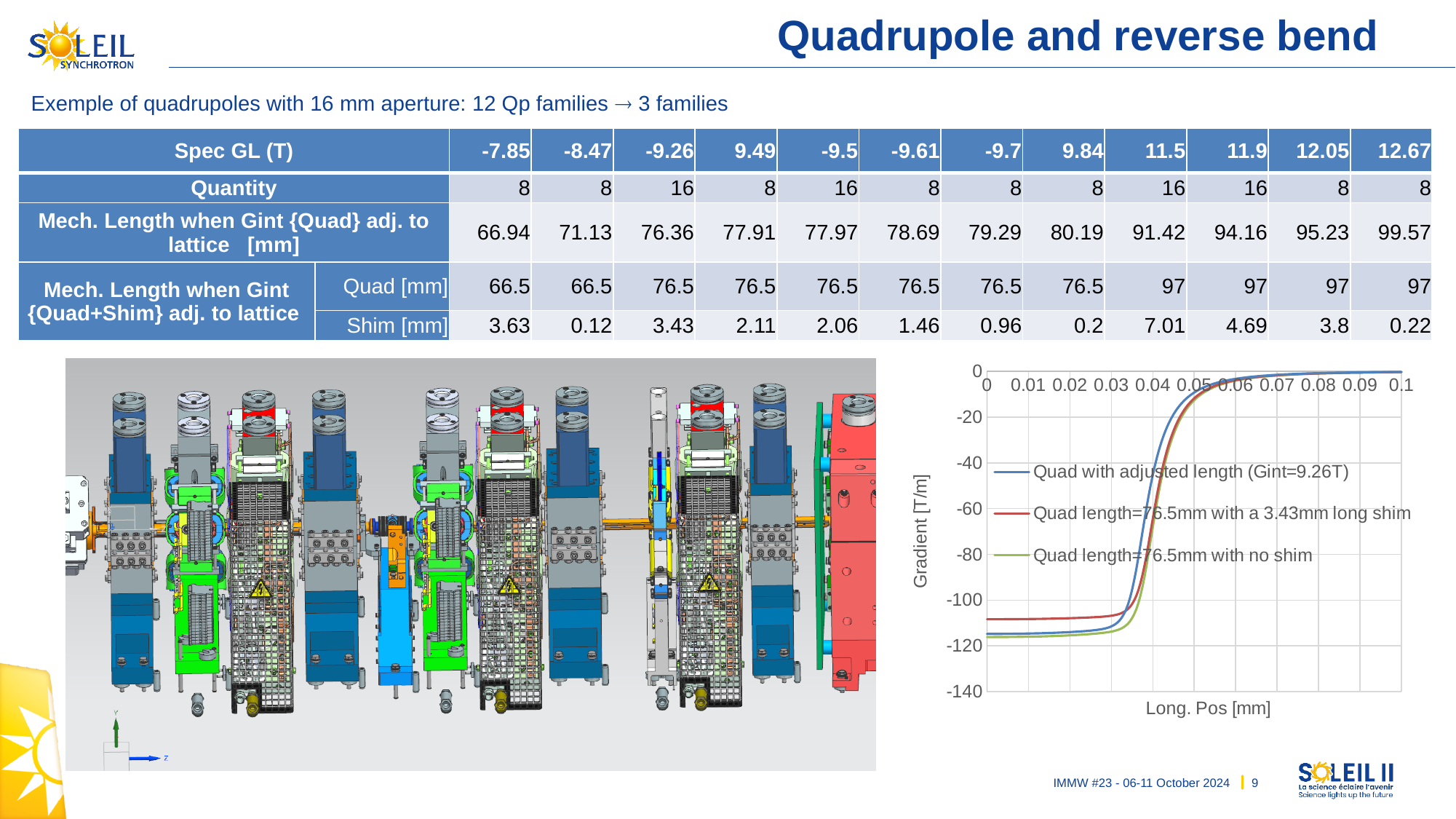
What is the label of the x axis of the gradient chart? Long. Pos [mm] How many series does the legend of the gradient chart list? 3 In the gradient chart, is the value of the 'Quad with adjusted length (Gint=9.26T)' series at position 0.1 greater or less than -20? greater In the gradient chart, do the values rise or fall as the longitudinal position increases from 0 to 0.1? rise In the gradient chart, is the value of the 'Quad length=76.5mm with a 3.43mm long shim' series at position 0 greater or less than -120? greater What is the label of the y axis of the gradient chart? Gradient [T/m] What is the highest value shown on the x axis of the gradient chart? 0.1 In the gradient chart, is the value of the 'Quad length=76.5mm with a 3.43mm long shim' series at position 0 greater or less than -100? less What is the lowest value shown on the y axis of the gradient chart? -140 In the gradient chart, at position 0, which series has the higher (less negative) gradient: 'Quad with adjusted length (Gint=9.26T)' or 'Quad length=76.5mm with a 3.43mm long shim'? Quad length=76.5mm with a 3.43mm long shim What kind of chart is shown on the right of the slide? line chart